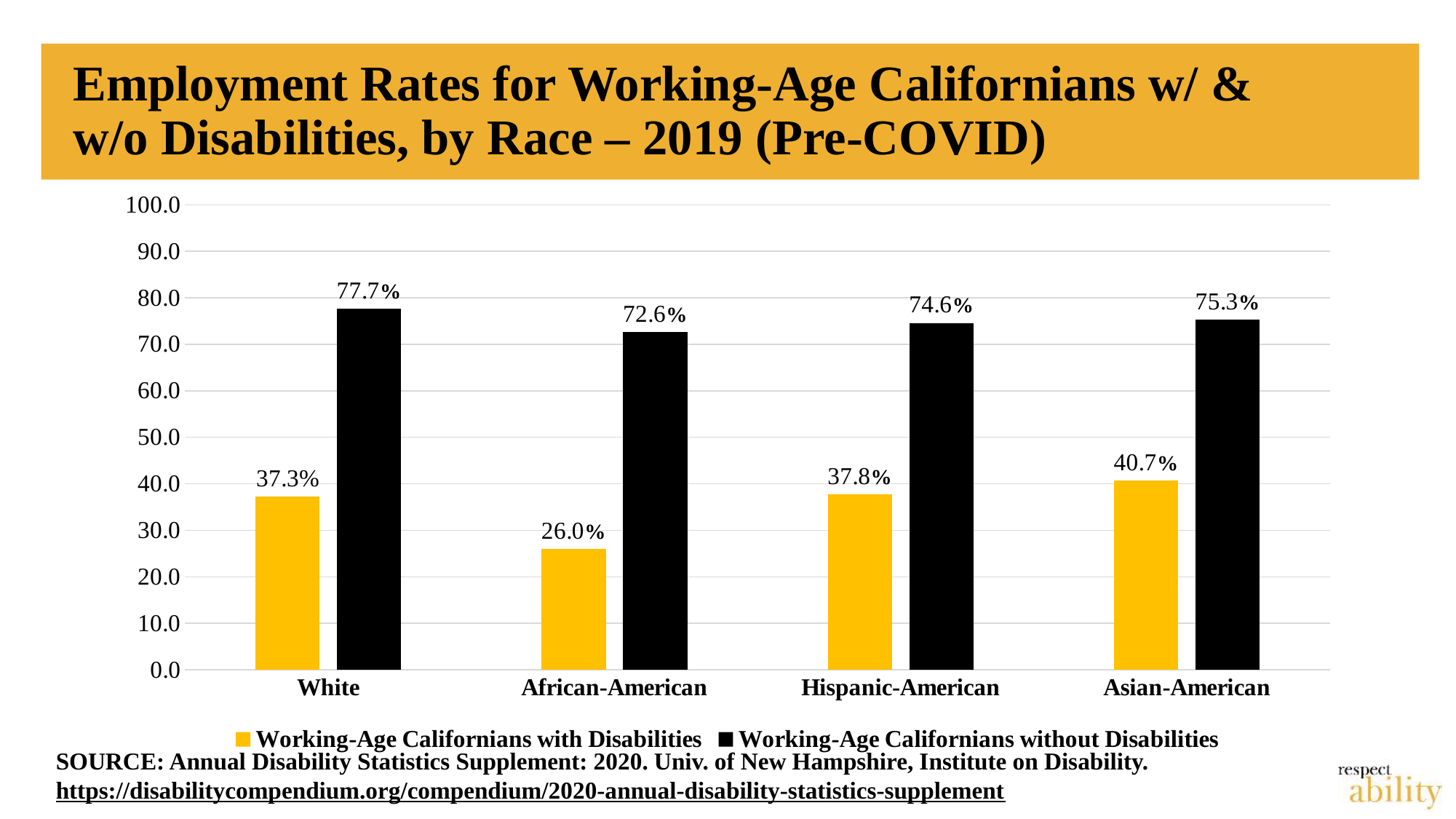
What is the employment rate for Working-Age Californians with Disabilities in the White category? 37.3% Which race category has the lowest employment rate for Working-Age Californians without Disabilities? African-American How many race categories are shown on the x axis? 4 How many series does the legend list? 2 Which colour represents Working-Age Californians without Disabilities? Black Which is larger: the employment rate for Working-Age Californians with Disabilities in the White category or in the African-American category? White Which race category has the highest employment rate for Working-Age Californians with Disabilities? Asian-American Is the employment rate for Working-Age Californians without Disabilities in the White category greater or less than 70.0? greater What kind of chart is shown on the slide? Bar chart What is the employment rate for Working-Age Californians without Disabilities in the African-American category? 72.6% What is the employment rate for Working-Age Californians with Disabilities in the Asian-American category? 40.7% What is the difference between the employment rates for Working-Age Californians without Disabilities and with Disabilities in the Hispanic-American category? 36.8%